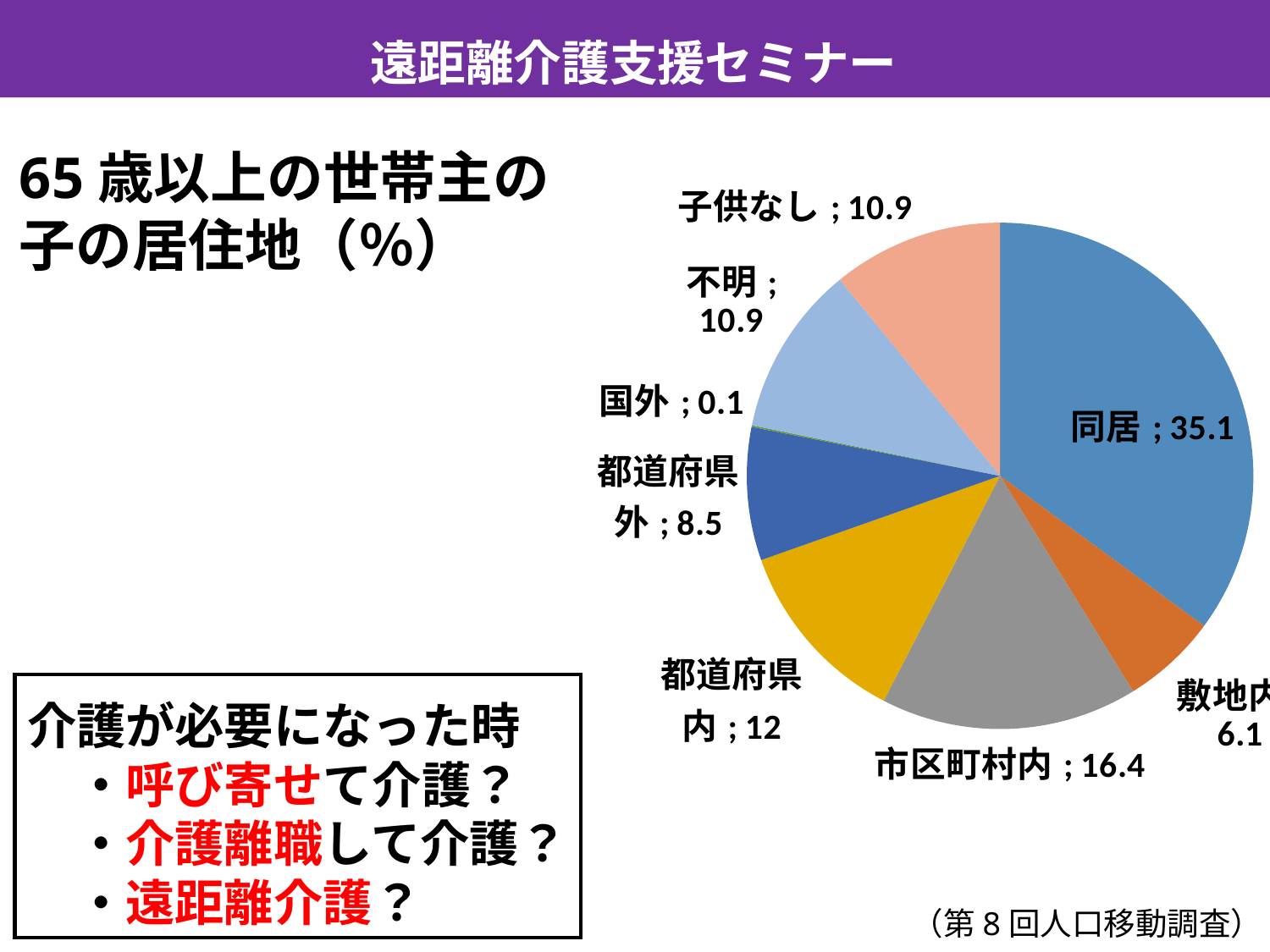
What is the title of the chart on the slide? 65歳以上の世帯主の子の居住地（%） What is the value for 市区町村内 in the pie chart? 16.4 Which category has the smallest slice in the pie chart? 国外 What is the value for 敷地内 in the pie chart? 6.1 What is the difference between the values for 同居 and 市区町村内? 18.7 What is the value for 同居 in the pie chart? 35.1 What kind of chart is shown on the slide? pie chart Which is larger, the value for 市区町村内 or the value for 都道府県内? 市区町村内 What share of the pie does 都道府県内 represent? 12 What is the value for 都道府県外 in the pie chart? 8.5 How many slices does the pie chart have? 8 Which category has the largest slice in the pie chart? 同居